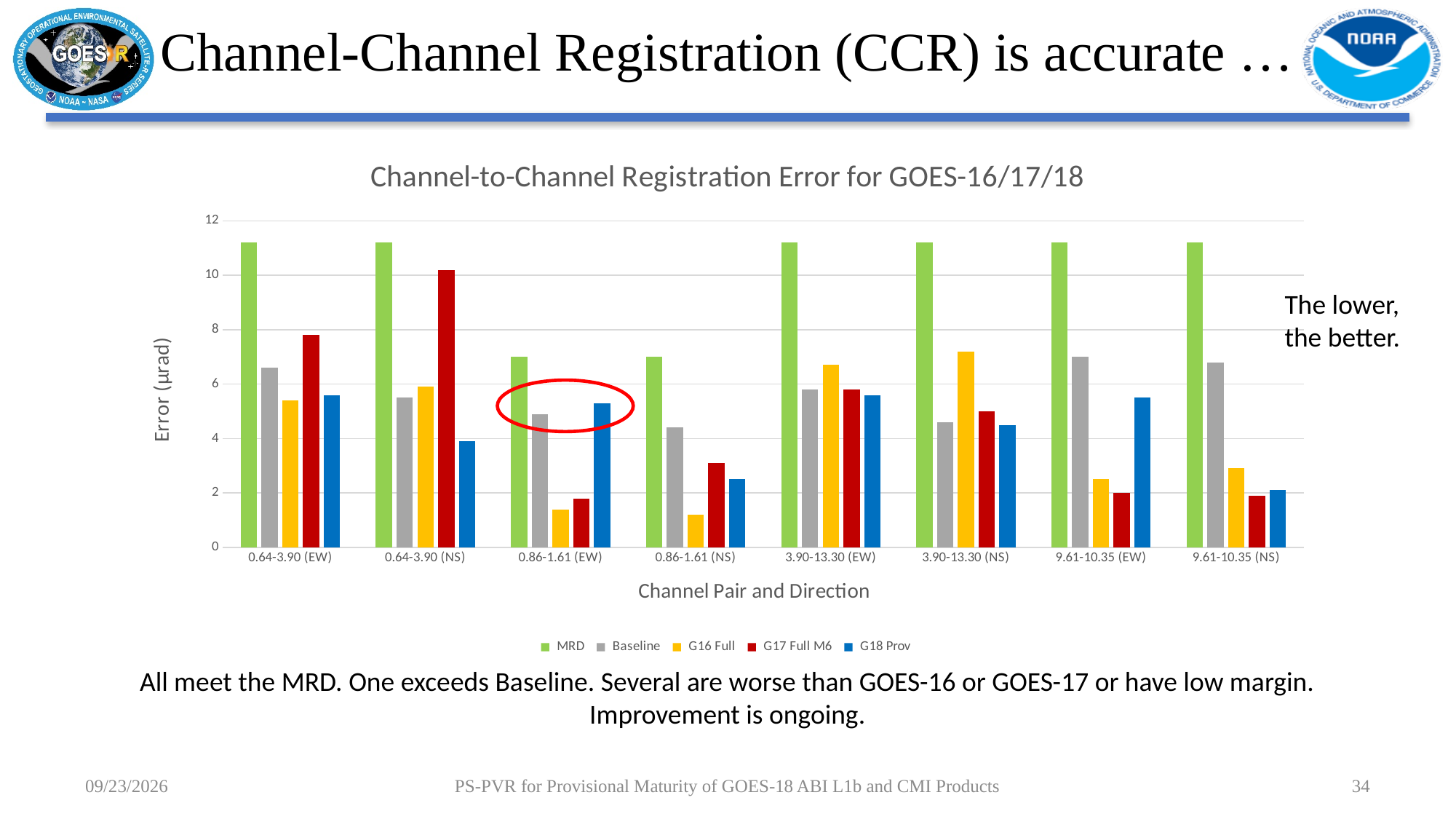
Is the G16 Full value for 0.86-1.61 (NS) greater or less than 2? less What is the title of the x axis? Channel Pair and Direction Is the MRD value for 0.86-1.61 (EW) greater or less than 8? less What kind of chart is shown on the slide? bar chart For 3.90-13.30 (NS), which is larger: the G16 Full value or the Baseline value? G16 Full What is the title of the y axis? Error (µrad) How many series does the legend list? 5 For 0.86-1.61 (EW), which is larger: the G18 Prov value or the G16 Full value? G18 Prov Which series has the lowest value for 0.64-3.90 (NS)? G18 Prov Which category has the highest G17 Full M6 value? 0.64-3.90 (NS) Is the G17 Full M6 value for 0.64-3.90 (NS) greater or less than 8? greater How many channel pair and direction categories are shown on the x axis? 8